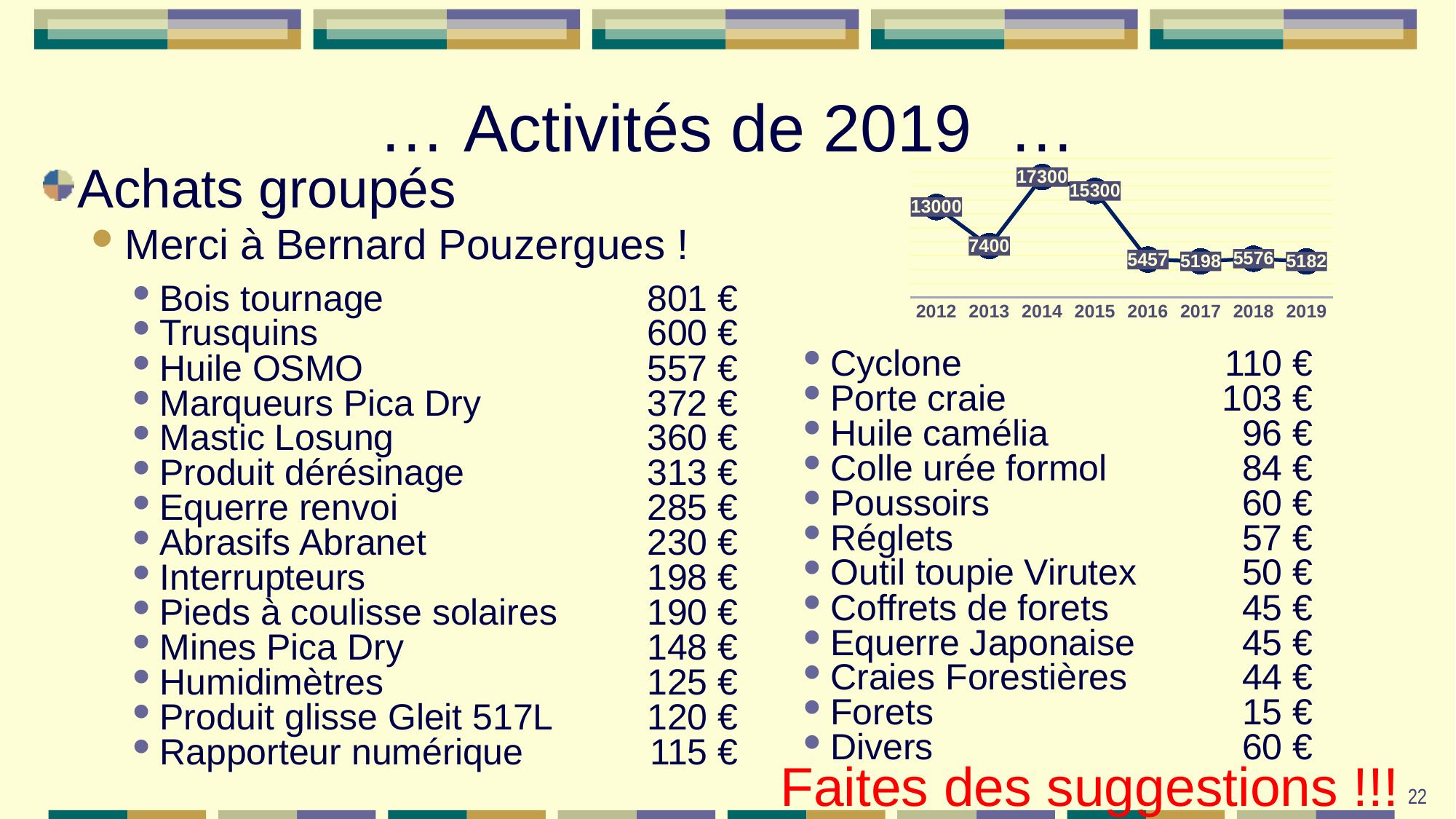
What is the value plotted for 2019? 5182 How many years are plotted on the chart? 8 Which is larger, the value for 2017 or the value for 2018? 2018 What is the value plotted for 2016? 5457 What is the value plotted for 2014? 17300 Which year has the lowest value on the chart? 2019 What is the difference between the values for 2014 and 2015? 2000 Do the values rise or fall from 2015 to 2016? fall Which year has the highest value on the chart? 2014 What type of chart is shown on the slide? line chart What is the value plotted for 2013? 7400 What is the difference between the values for 2012 and 2013? 5600